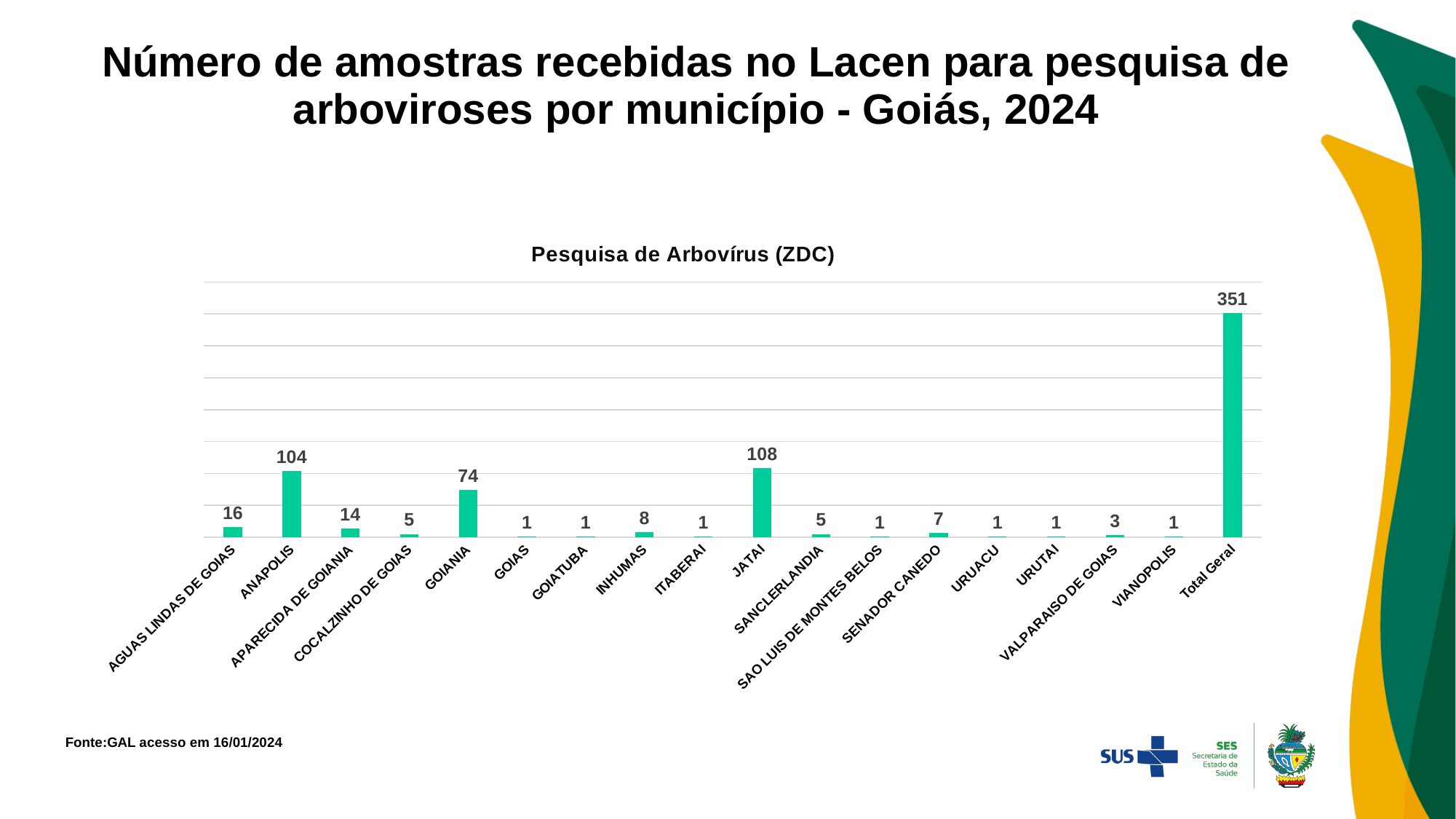
What is the difference between the values for JATAI and ANAPOLIS? 4 What is the value for GOIANIA in the chart? 74 What is the value shown for Total Geral? 351 What is the value for ANAPOLIS in the chart? 104 Which has a larger value, AGUAS LINDAS DE GOIAS or APARECIDA DE GOIANIA? AGUAS LINDAS DE GOIAS What is the value for SENADOR CANEDO? 7 What is the difference between the values for ANAPOLIS and GOIANIA? 30 What is the title of the chart? Pesquisa de Arbovírus (ZDC) How many categories are shown on the x axis, including Total Geral? 18 Excluding the Total Geral bar, which municipality has the highest value? JATAI What is the value for JATAI in the chart? 108 What type of chart is shown on the slide? Bar chart